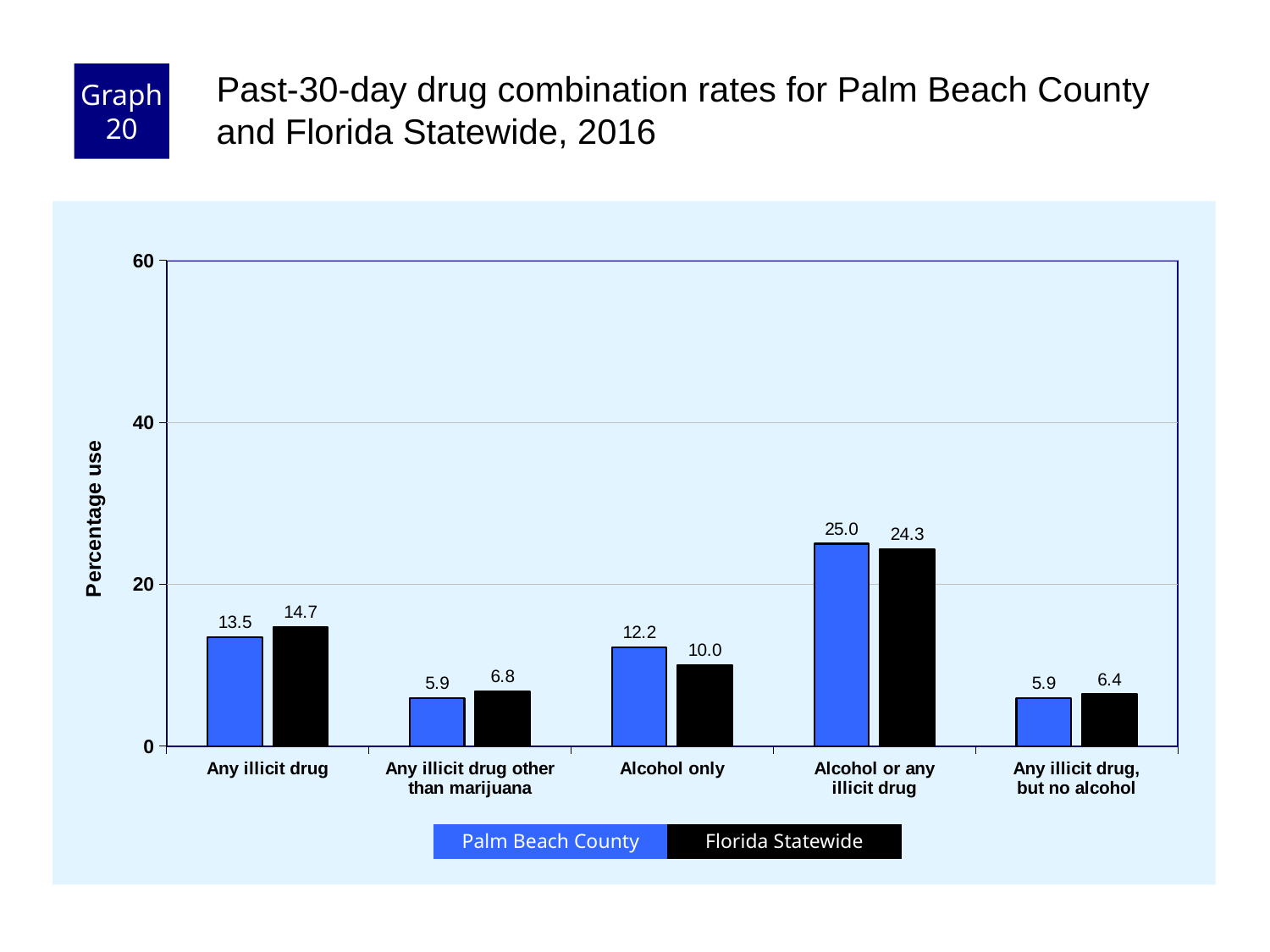
What is the difference between the Florida Statewide and Palm Beach County values for Any illicit drug other than marijuana? 0.9 Is the Florida Statewide value for Alcohol or any illicit drug greater or less than 20? greater What is the Palm Beach County value for Alcohol only? 12.2 What type of chart is shown on the slide? Bar chart What is the Florida Statewide value for Any illicit drug, but no alcohol? 6.4 How many series does the legend list? 2 How many categories are shown on the x axis? 5 What is the difference between the Palm Beach County and Florida Statewide values for Alcohol only? 2.2 For Alcohol or any illicit drug, which is larger: Palm Beach County or Florida Statewide? Palm Beach County What is the Florida Statewide value for Any illicit drug? 14.7 Which category has the highest Palm Beach County value? Alcohol or any illicit drug Which category has the lowest Florida Statewide value? Any illicit drug, but no alcohol